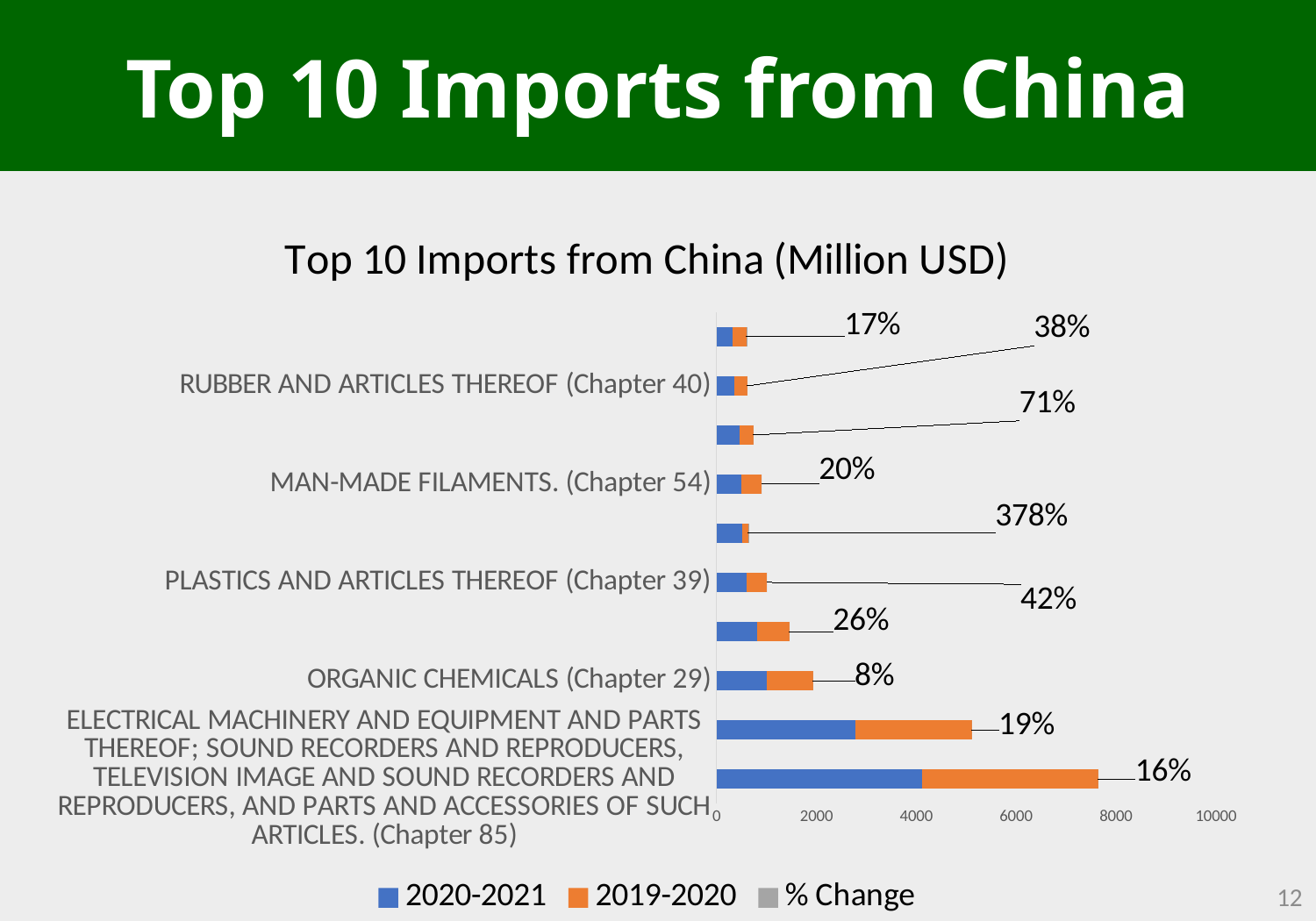
What is the % Change for ORGANIC CHEMICALS (Chapter 29)? 8% What is the title of the chart? Top 10 Imports from China (Million USD) Which of the labelled categories has the lowest % Change? ORGANIC CHEMICALS (Chapter 29) What is the % Change for ELECTRICAL MACHINERY AND EQUIPMENT (Chapter 85)? 16% What kind of chart is shown on the slide? bar chart What is the % Change for PLASTICS AND ARTICLES THEREOF (Chapter 39)? 42% How many series does the legend list? 3 What is the % Change for RUBBER AND ARTICLES THEREOF (Chapter 40)? 38% What is the % Change for MAN-MADE FILAMENTS. (Chapter 54)? 20% What is the highest % Change value labelled on the chart? 378% How many bars are plotted in the chart? 10 Is the total stacked bar for ELECTRICAL MACHINERY AND EQUIPMENT (Chapter 85) greater or less than 6000? greater